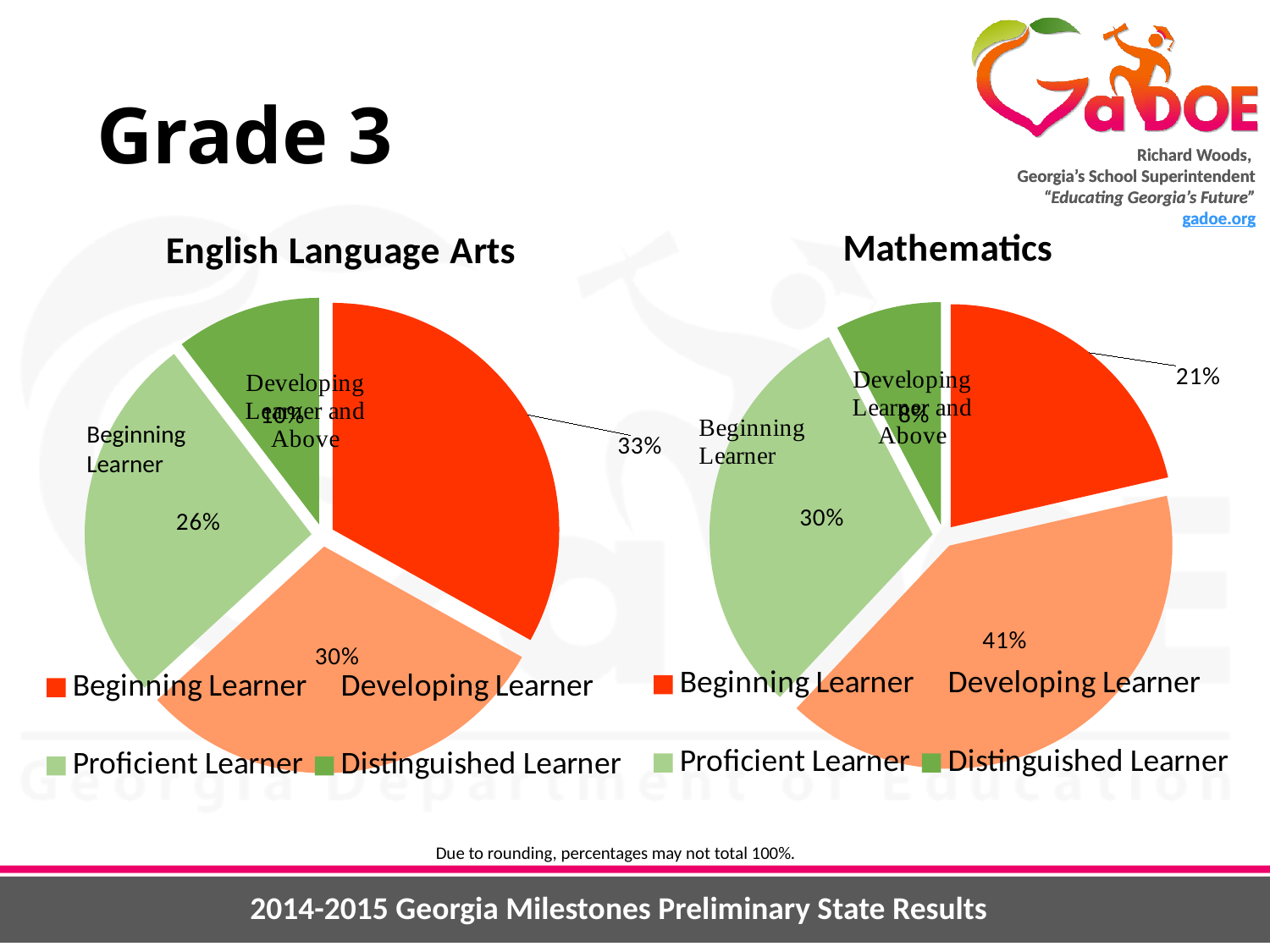
In the legend of the Mathematics chart, which category is shown in dark green? Distinguished Learner In the English Language Arts chart, what percentage is shown for Beginning Learner? 33% How many categories does the Mathematics pie chart have? 4 In the Mathematics chart, what percentage is shown for Proficient Learner? 30% In the Mathematics chart, which category has the largest share? Developing Learner What type of chart is used for English Language Arts? Pie chart In the English Language Arts chart, what percentage is shown for Distinguished Learner? 10% In the Mathematics chart, what percentage is shown for Developing Learner? 41% Which chart shows a larger percentage for Beginning Learner, English Language Arts or Mathematics? English Language Arts In the Mathematics chart, what is the difference between the Developing Learner and Beginning Learner percentages? 20% In the English Language Arts chart, which category has the smallest share? Distinguished Learner In the English Language Arts chart, what is the difference between the Proficient Learner and Distinguished Learner percentages? 16%